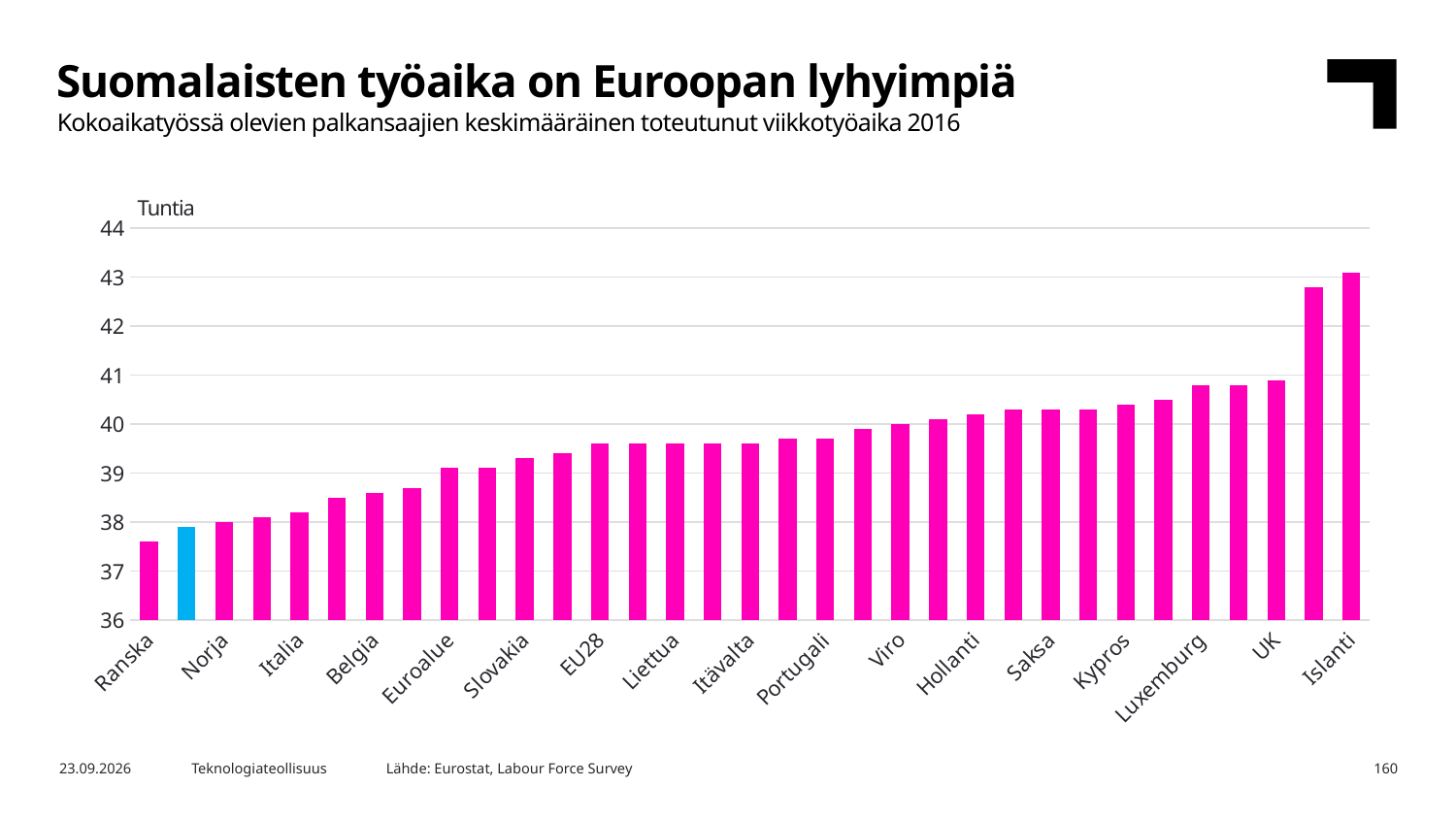
Which country has the highest average weekly working time in the chart? Islanti Is the value for Islanti greater or less than 42? greater Which country has the lowest average weekly working time in the chart? Ranska Which has a higher value, Islanti or UK? Islanti Is the value for Luxemburg greater or less than 41? less What kind of chart is shown on the slide? bar chart Is the value for Itävalta greater or less than 40? less What unit is shown at the top of the vertical axis? Tuntia Do the bar values rise or fall from left to right along the x axis? rise